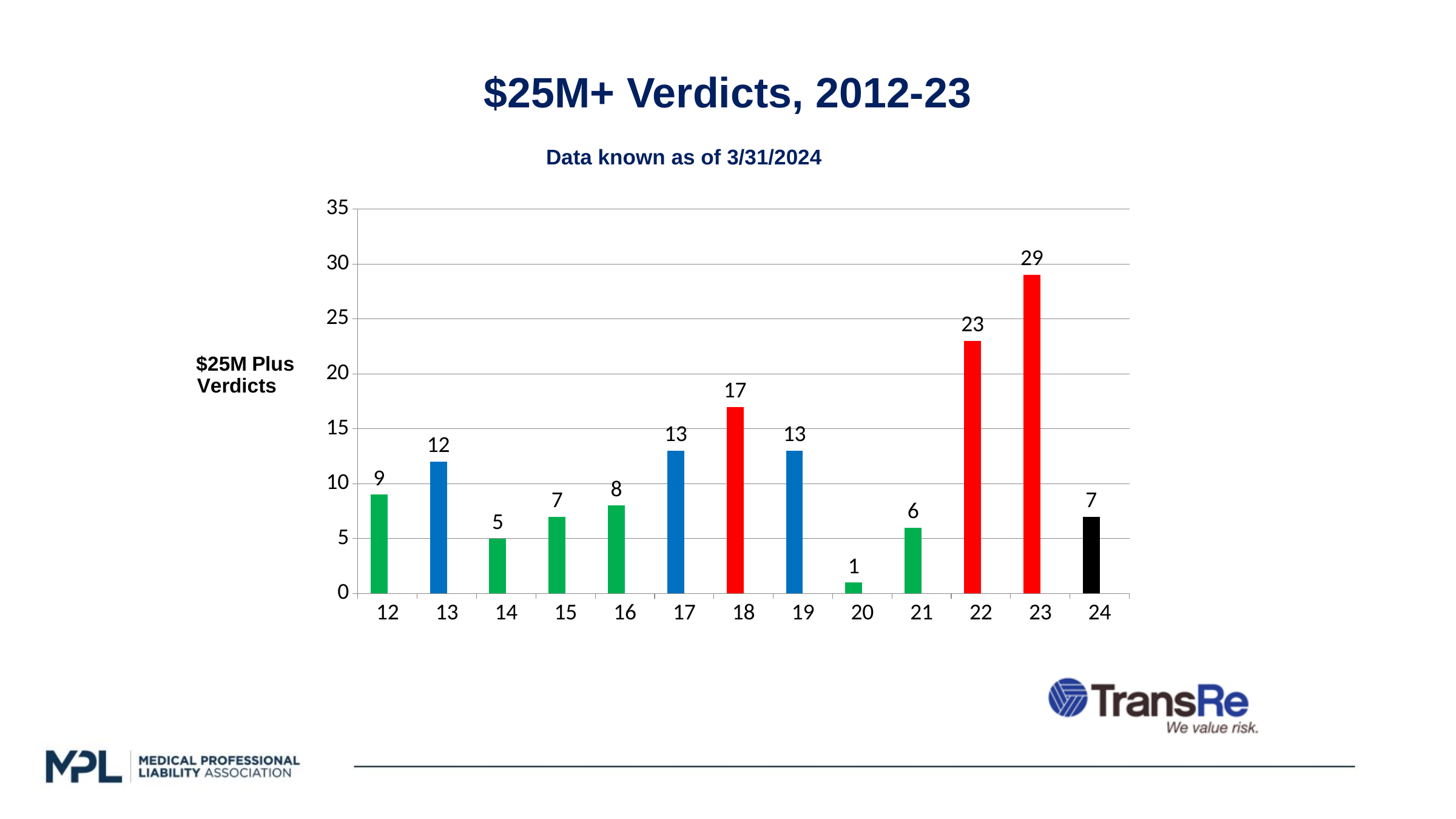
What is the title of the chart on the slide? $25M+ Verdicts, 2012-23 What is the number of $25M+ verdicts shown for 24? 7 How many years are shown on the x axis? 13 Is the value for 22 greater or less than 20? greater What is the difference between the values for 23 and 22? 6 What kind of chart is shown on the slide? bar chart Which year has the lowest number of $25M+ verdicts? 20 What is the number of $25M+ verdicts shown for 18? 17 Which is larger, the value for 13 or the value for 16? 13 What is the number of $25M+ verdicts shown for 23? 29 What is the difference between the values for 18 and 14? 12 Which year has the highest number of $25M+ verdicts? 23